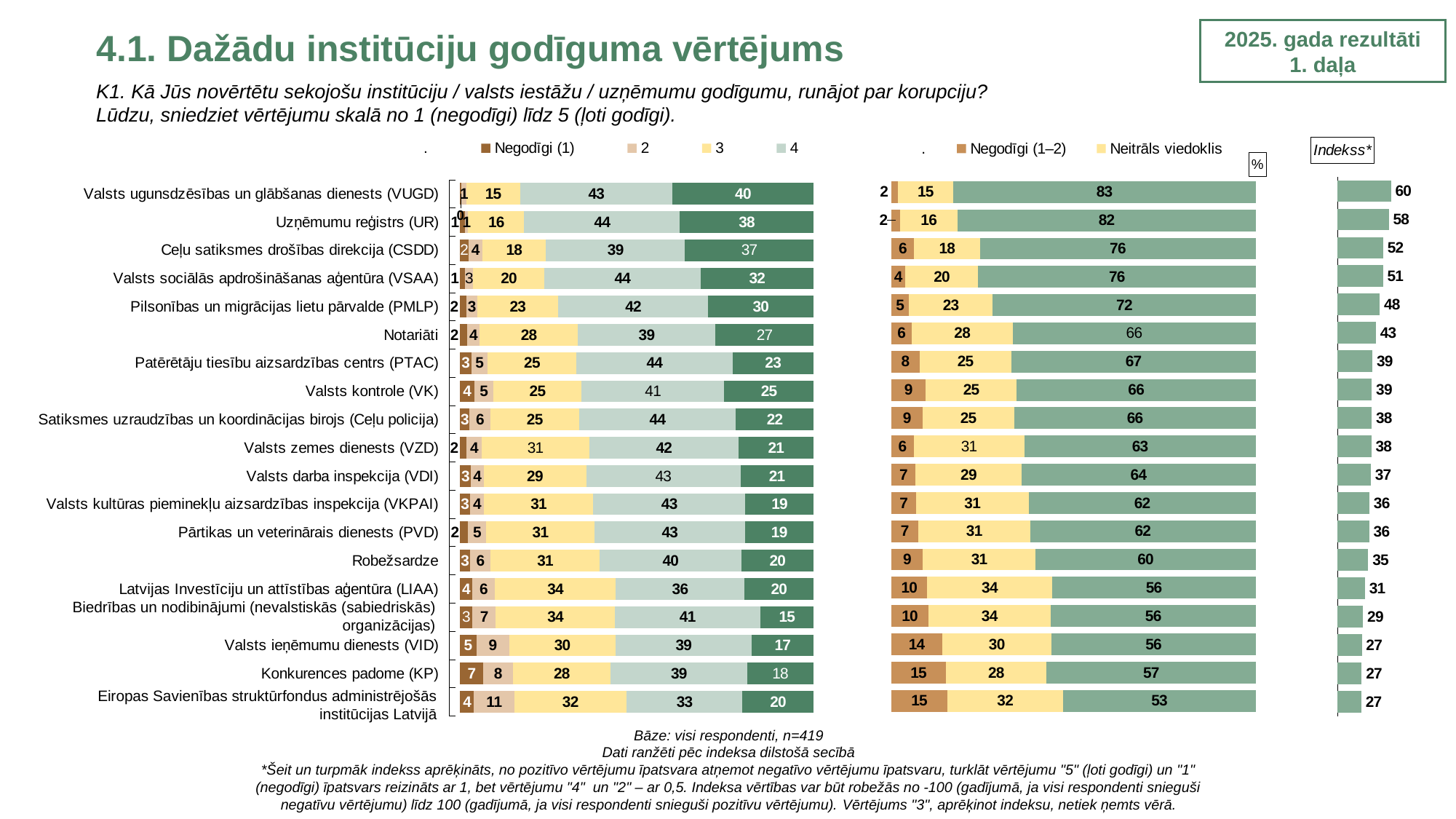
In the middle chart, which has the larger Negodīgi (1–2) value: Konkurences padome (KP) or Ceļu satiksmes drošības direkcija (CSDD)? Konkurences padome (KP) In the left chart, what is the value of the '4' rating for Uzņēmumu reģistrs (UR)? 44 In the middle chart, which institution has the largest green (positive) segment? Valsts ugunsdzēsības un glābšanas dienests (VUGD) In the left chart, what is the Negodīgi (1) value for Konkurences padome (KP)? 7 In the middle chart, what is the Negodīgi (1–2) value for Valsts ieņēmumu dienests (VID)? 14 In the Indekss* chart on the right, what is the difference between the index for VUGD and the index for Uzņēmumu reģistrs (UR)? 2 In the middle chart, what is the Neitrāls viedoklis value for Notariāti? 28 In the left chart, what is the value of the '3' rating for Robežsardze? 31 In the Indekss* chart on the right, which institution has the highest index? Valsts ugunsdzēsības un glābšanas dienests (VUGD) How many institutions are listed in the charts on the slide? 19 In the Indekss* chart on the right, what is the index value for Valsts ugunsdzēsības un glābšanas dienests (VUGD)? 60 What kind of chart is used on the slide? Bar chart